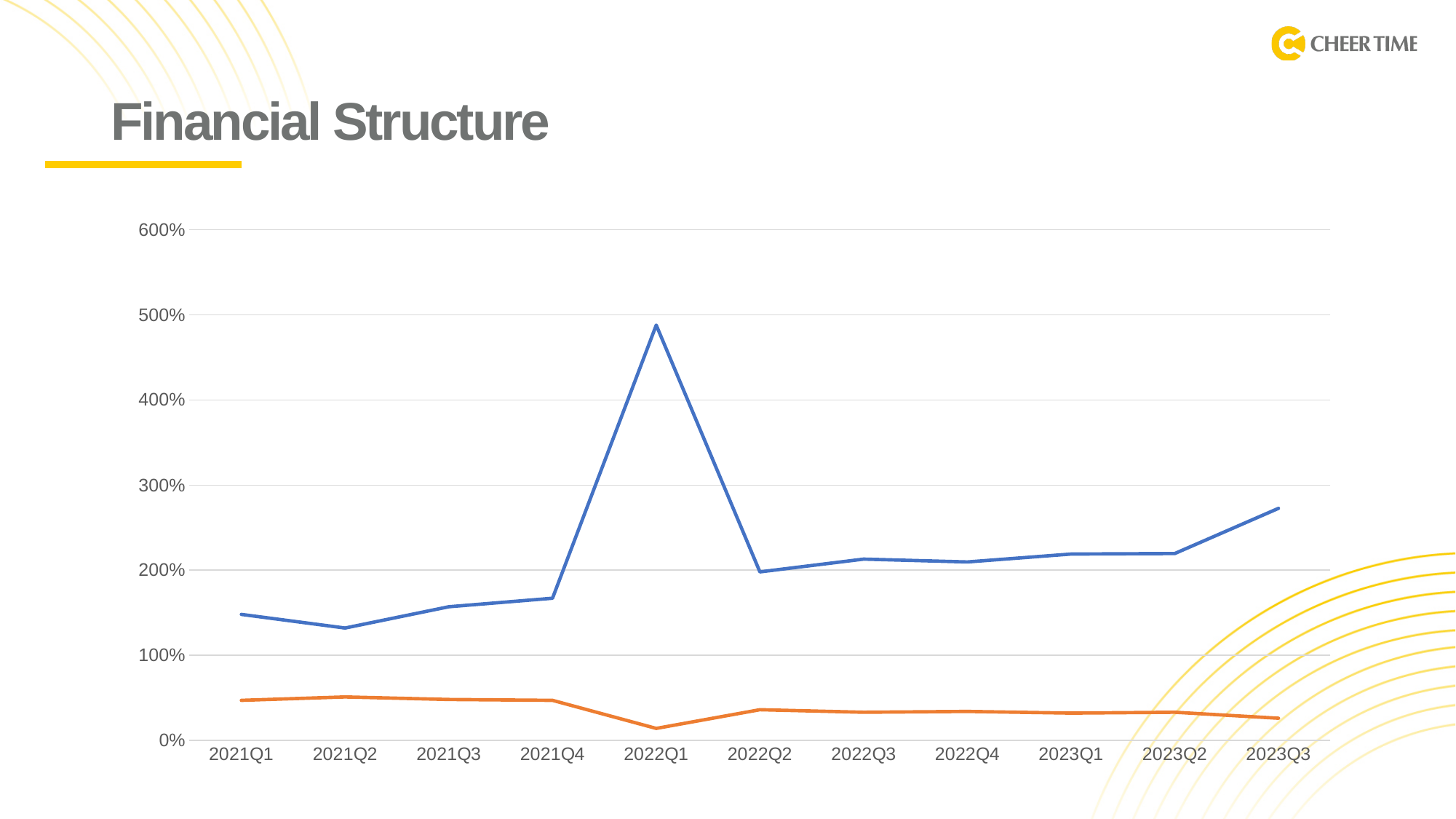
Is the value of the blue line at 2022Q1 greater or less than 400%? greater In which quarter does the blue line reach its lowest value? 2021Q2 Is the value of the orange line at 2021Q2 greater or less than 100%? less Is the value of the blue line at 2023Q3 greater or less than 200%? greater How many lines are plotted on the chart? 2 What kind of chart is shown on the slide? line chart How many quarters are shown on the x axis of the chart? 11 At 2023Q3, which line has the higher value, the blue line or the orange line? the blue line In which quarter does the blue line reach its highest value? 2022Q1 In which quarter does the orange line reach its lowest value? 2022Q1 Does the blue line rise or fall from 2022Q2 to 2023Q3? rise